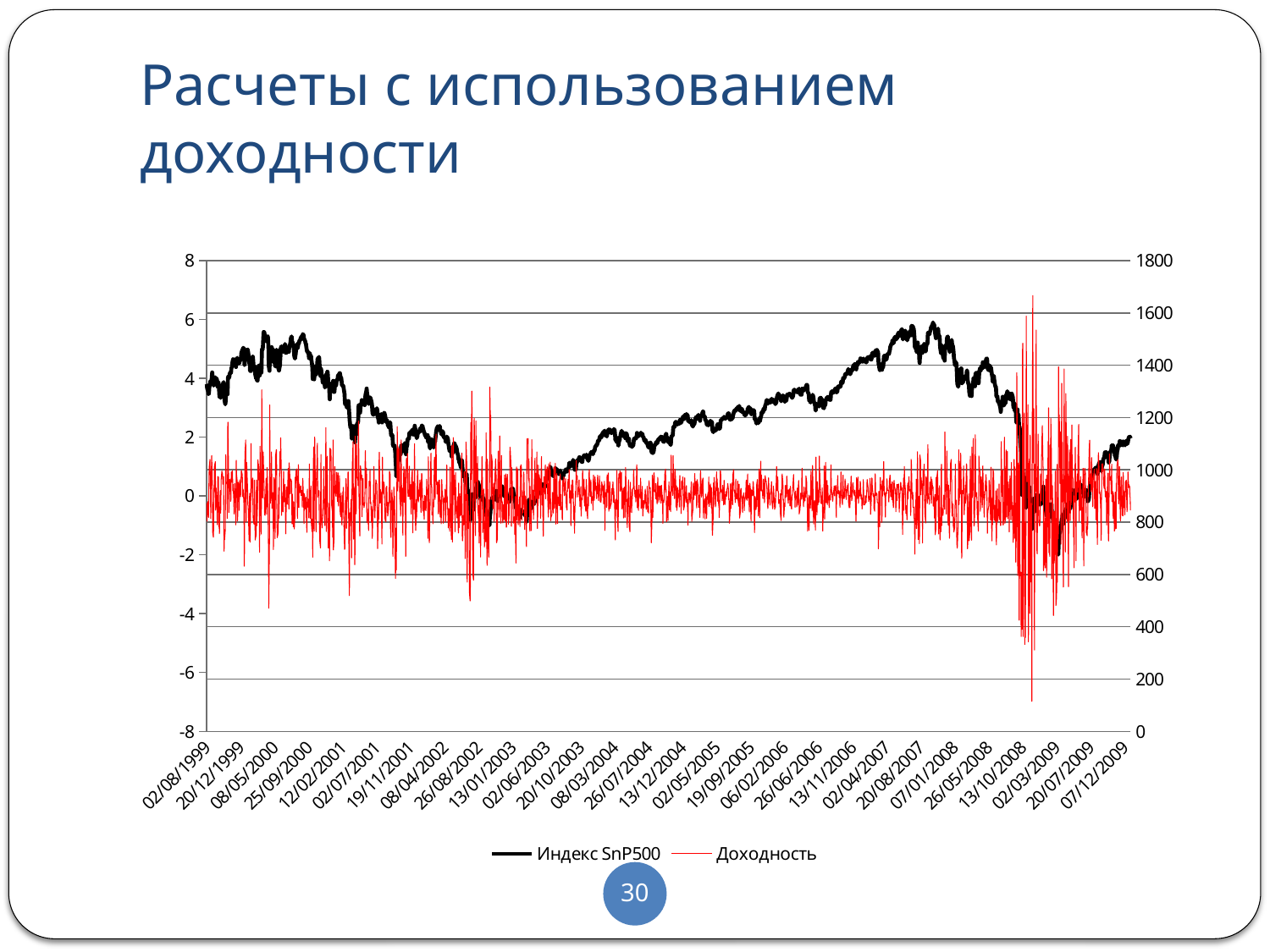
Does Индекс SnP500 rise or fall between 07/01/2008 and 02/03/2009? fall Does Индекс SnP500 rise or fall between 13/01/2003 and 02/04/2007? rise Which is higher for Индекс SnP500: the value at 02/04/2007 or the value at 02/03/2009? 02/04/2007 What kind of chart is shown on the slide? line chart Is the value of Индекс SnP500 at 02/03/2009 greater or less than 800? less What is the highest value shown on the right-hand vertical axis? 1800 Which series is drawn in red? Доходность How many date labels are shown on the x axis? 28 Is the value of Индекс SnP500 at 13/01/2003 greater or less than 1000? less How many series does the legend list? 2 Is the value of Индекс SnP500 at 02/04/2007 greater or less than 1400? greater